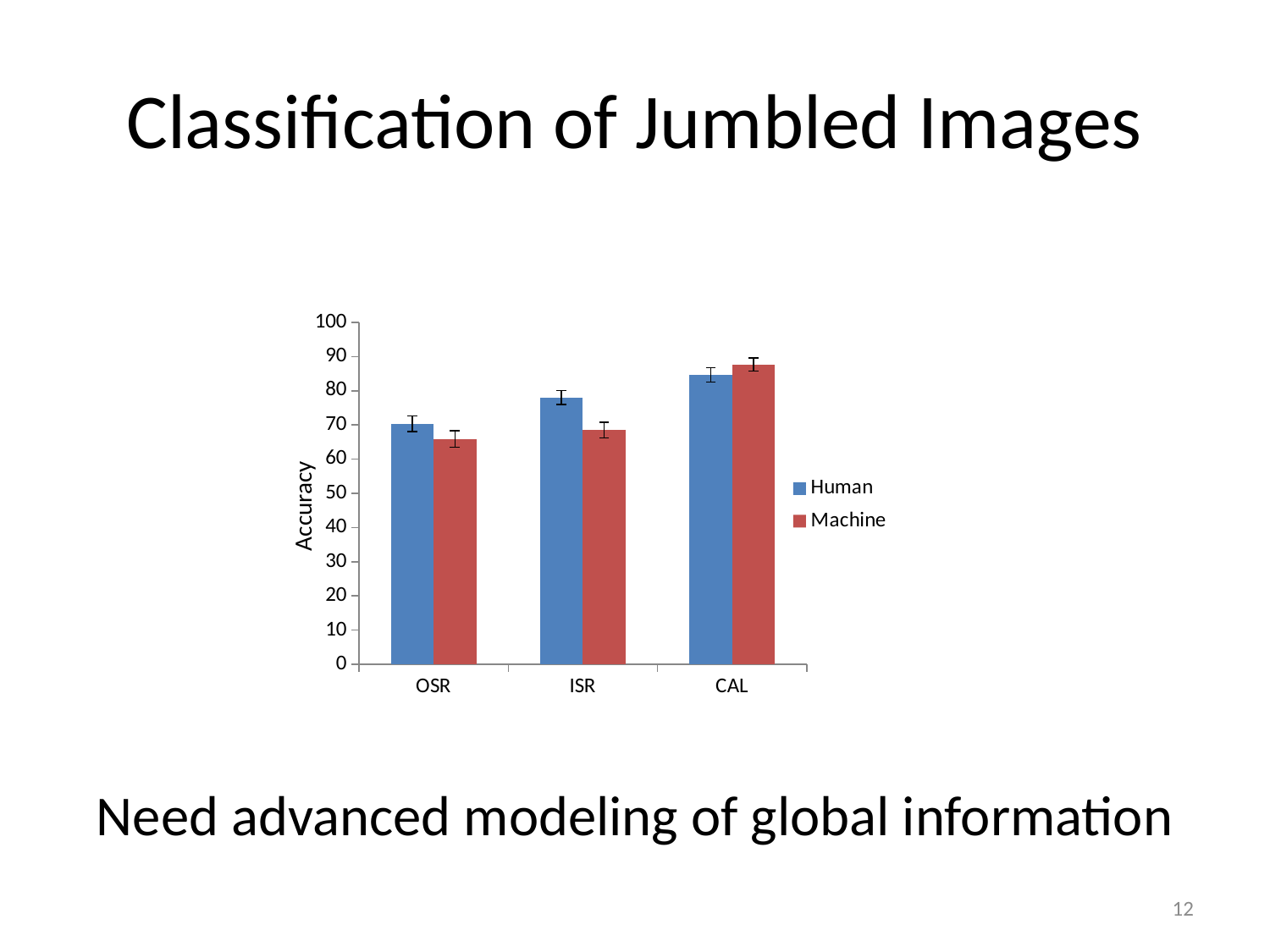
For which category is the Machine accuracy highest? CAL For ISR, which is larger, the Human or the Machine accuracy? Human For which category is the Human accuracy highest? CAL For OSR, which is larger, the Human or the Machine accuracy? Human Is the Human accuracy for ISR greater or less than 70? greater How many categories are shown on the x axis? 3 What is the label of the y axis? Accuracy Is the Machine accuracy for OSR greater or less than 70? less For which category is the Human accuracy lowest? OSR How many series does the legend list? 2 Which series is shown in red? Machine What kind of chart is shown on the slide? bar chart